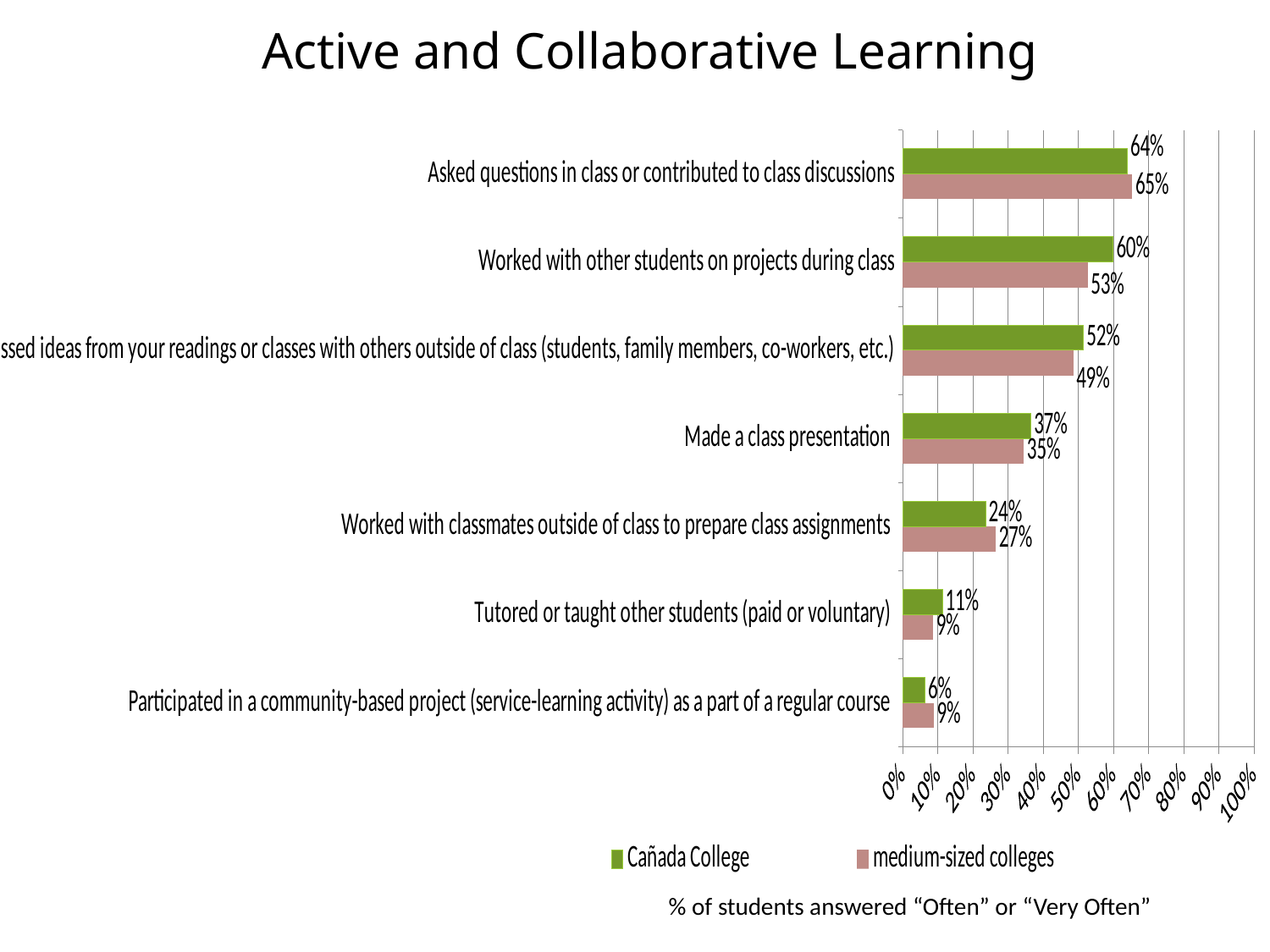
What is the Cañada College value for "Made a class presentation"? 37% What is the medium-sized colleges value for "Tutored or taught other students (paid or voluntary)"? 9% What is the Cañada College value for "Asked questions in class or contributed to class discussions"? 64% Which category has the highest medium-sized colleges value? Asked questions in class or contributed to class discussions Which category has the lowest Cañada College value? Participated in a community-based project (service-learning activity) as a part of a regular course For "Worked with classmates outside of class to prepare class assignments", which series has the larger value, Cañada College or medium-sized colleges? medium-sized colleges What kind of chart is shown on the slide? bar chart What is the medium-sized colleges value for "Worked with other students on projects during class"? 53% What is the title of the chart? Active and Collaborative Learning How many series does the legend list? 2 How many categories are plotted in the chart? 7 What is the difference between the Cañada College and medium-sized colleges values for "Worked with other students on projects during class"? 7%